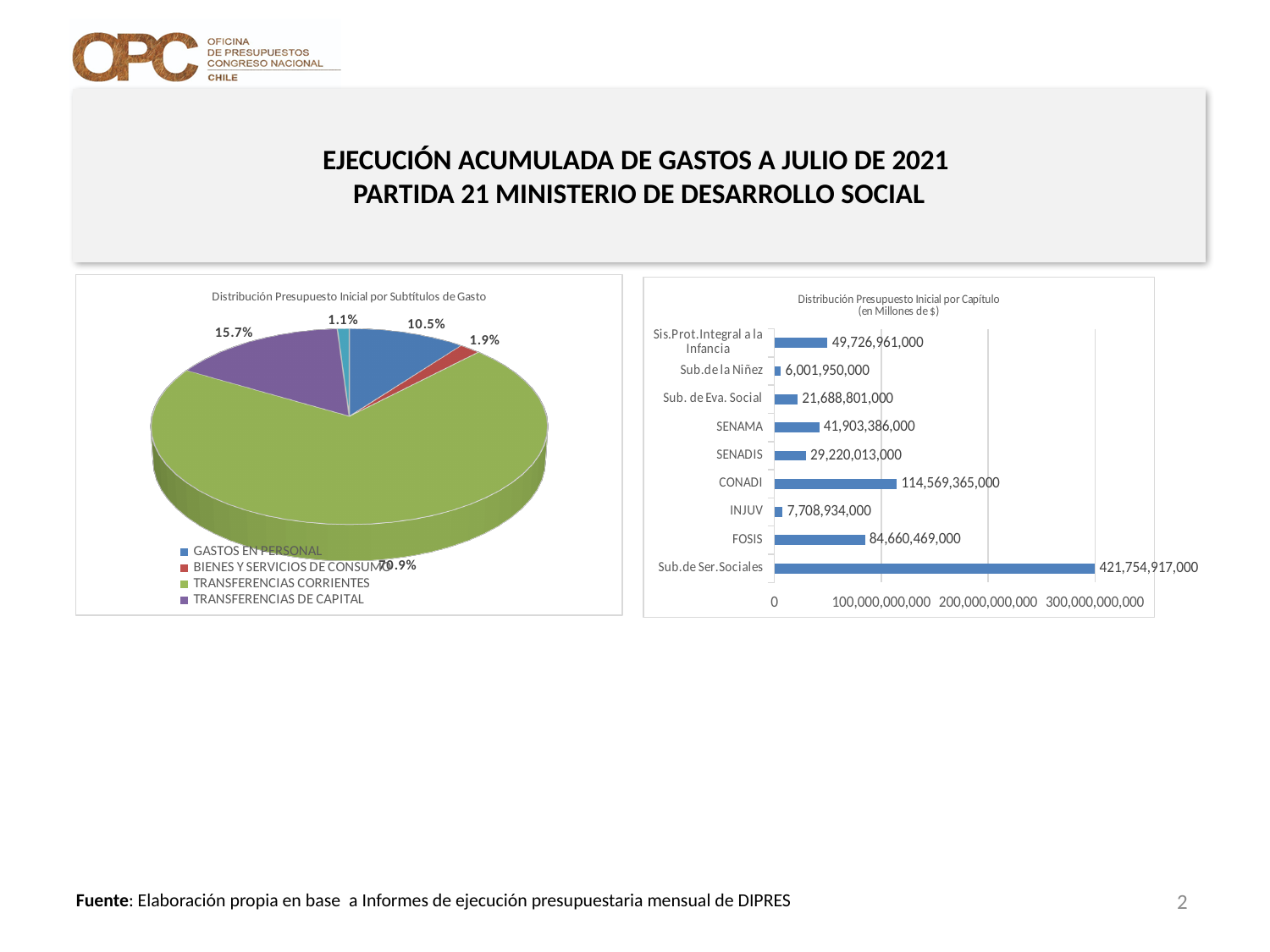
In the bar chart on the right, which is larger: the value for INJUV or the value for Sub. de Eva. Social? Sub. de Eva. Social In the bar chart on the right, what is the difference between the values for SENAMA and SENADIS? 12,683,373,000 In the bar chart on the right, which category has the highest value? Sub.de Ser.Sociales How many categories are shown in the bar chart on the right? 9 How many entries does the legend of the pie chart on the left list? 4 In the pie chart on the left, what share does TRANSFERENCIAS DE CAPITAL have? 15.7% In the bar chart on the right, which category has the lowest value? Sub.de la Niñez In the bar chart on the right, is the value for Sub.de Ser.Sociales greater or less than 300,000,000,000? greater What kind of chart is the chart on the left? Pie chart In the bar chart on the right, what is the value for FOSIS? 84,660,469,000 In the pie chart on the left, what share does TRANSFERENCIAS CORRIENTES have? 70.9% In the bar chart on the right, what is the value for CONADI? 114,569,365,000